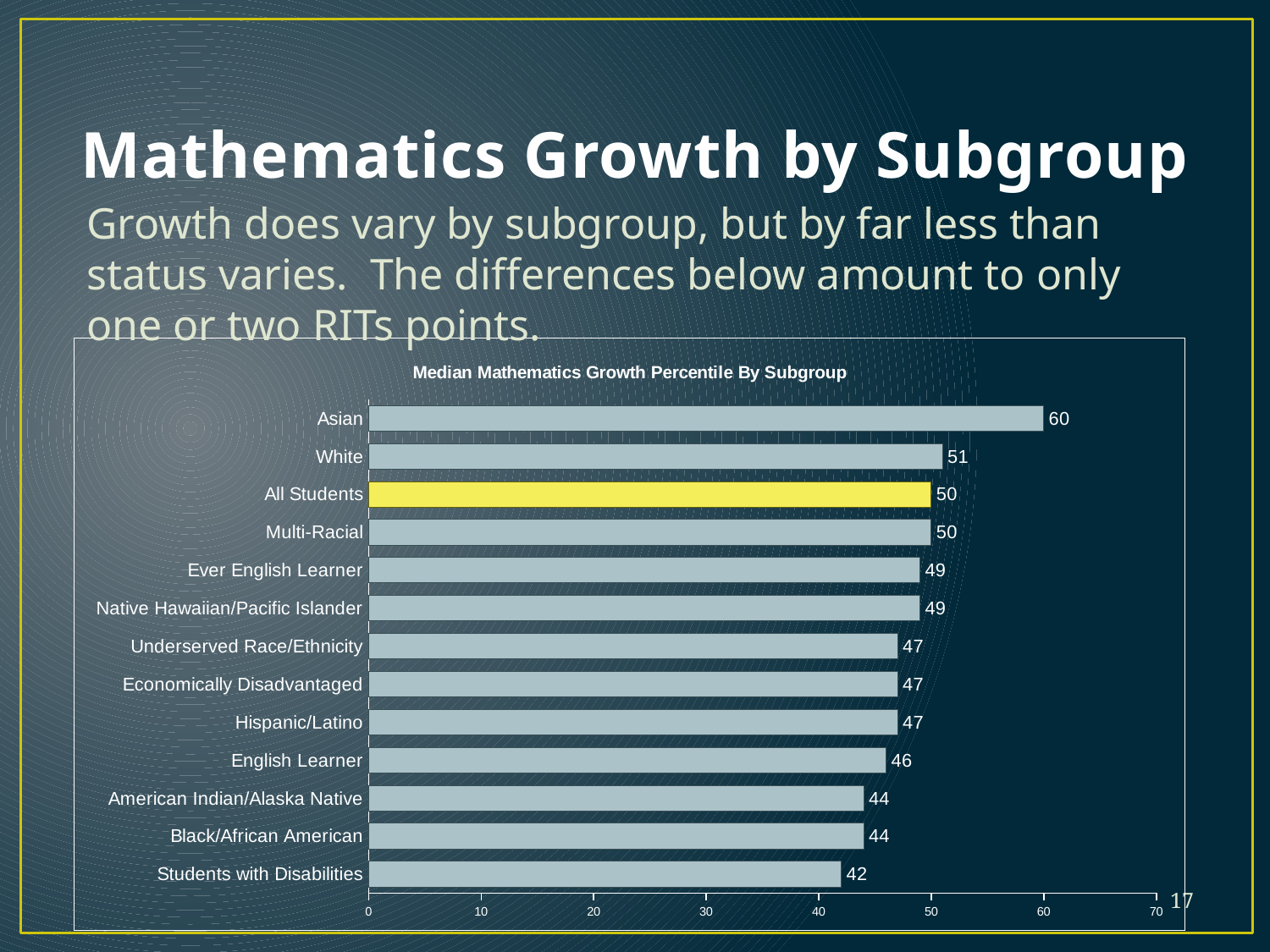
What is the value shown for Hispanic/Latino? 47 What kind of chart is shown on the slide? Bar chart What is the median mathematics growth percentile for Asian students? 60 How many subgroups (bars) are shown in the chart? 13 What is the value shown for Students with Disabilities? 42 Which bar is highlighted in yellow? All Students What is the difference between the values for Asian and Black/African American? 16 What is the title of the chart? Median Mathematics Growth Percentile By Subgroup Which subgroup has the lowest median mathematics growth percentile? Students with Disabilities What is the difference between the values for White and All Students? 1 Which is larger, the value for English Learner or the value for Ever English Learner? Ever English Learner Which subgroup has the highest median mathematics growth percentile? Asian